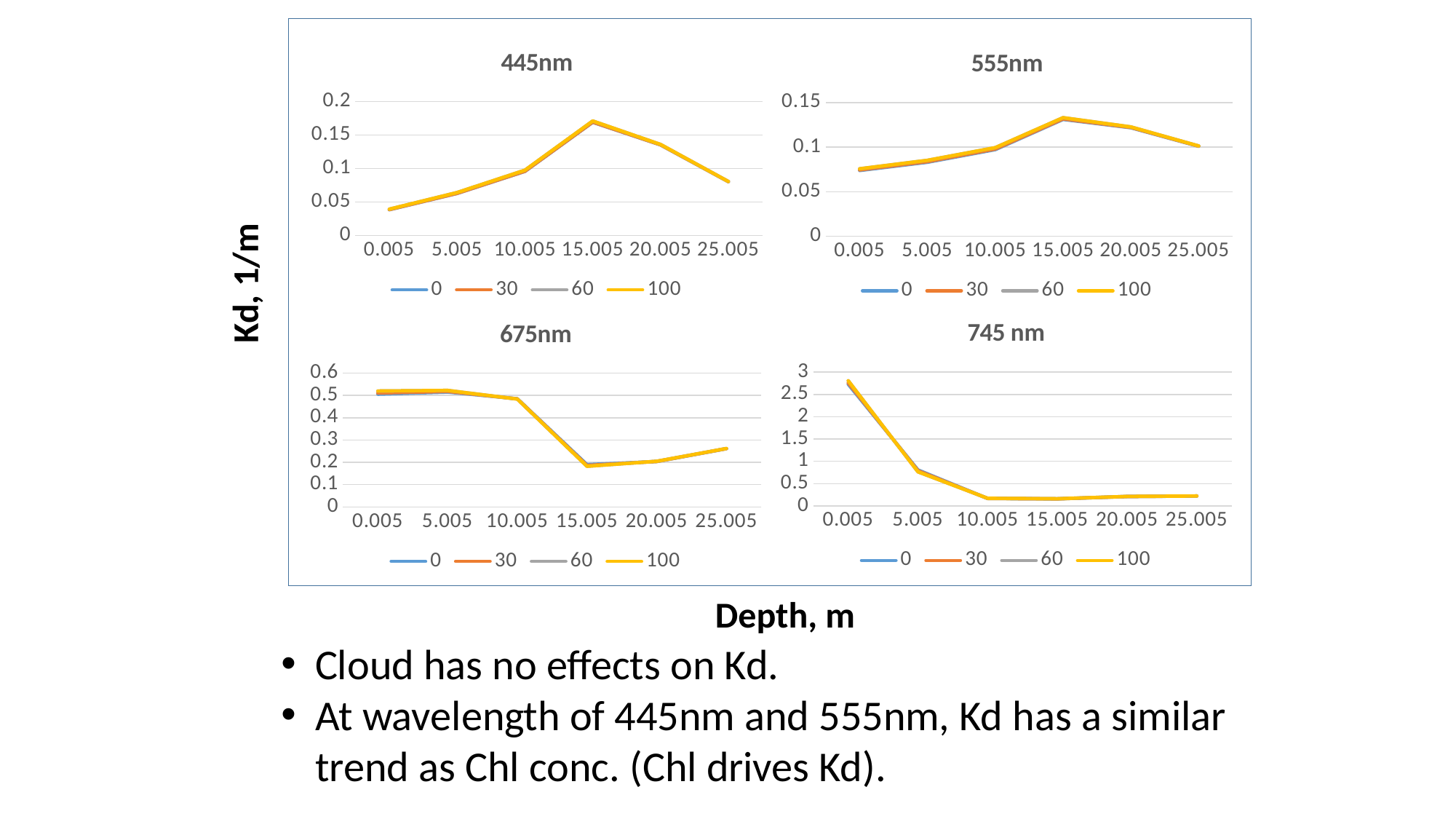
In the 445nm chart, is the value at depth 15.005 greater or less than 0.15? greater How many series does the legend of the 555nm chart list? 4 In the 555nm chart, at which depth is Kd highest? 15.005 In the 555nm chart, is the value at depth 0.005 greater or less than 0.1? less In the 445nm chart, at which depth is Kd lowest? 0.005 How many depth points are plotted along the x axis of the 675nm chart? 6 In the 675nm chart, is the value at depth 10.005 greater or less than 0.4? greater In the 745 nm chart, do the values rise or fall from depth 0.005 to depth 10.005? fall In the 675nm chart, at which depth is Kd lowest? 15.005 In the 445nm chart, at which depth is Kd highest? 15.005 What kind of chart is the 445nm chart? line chart